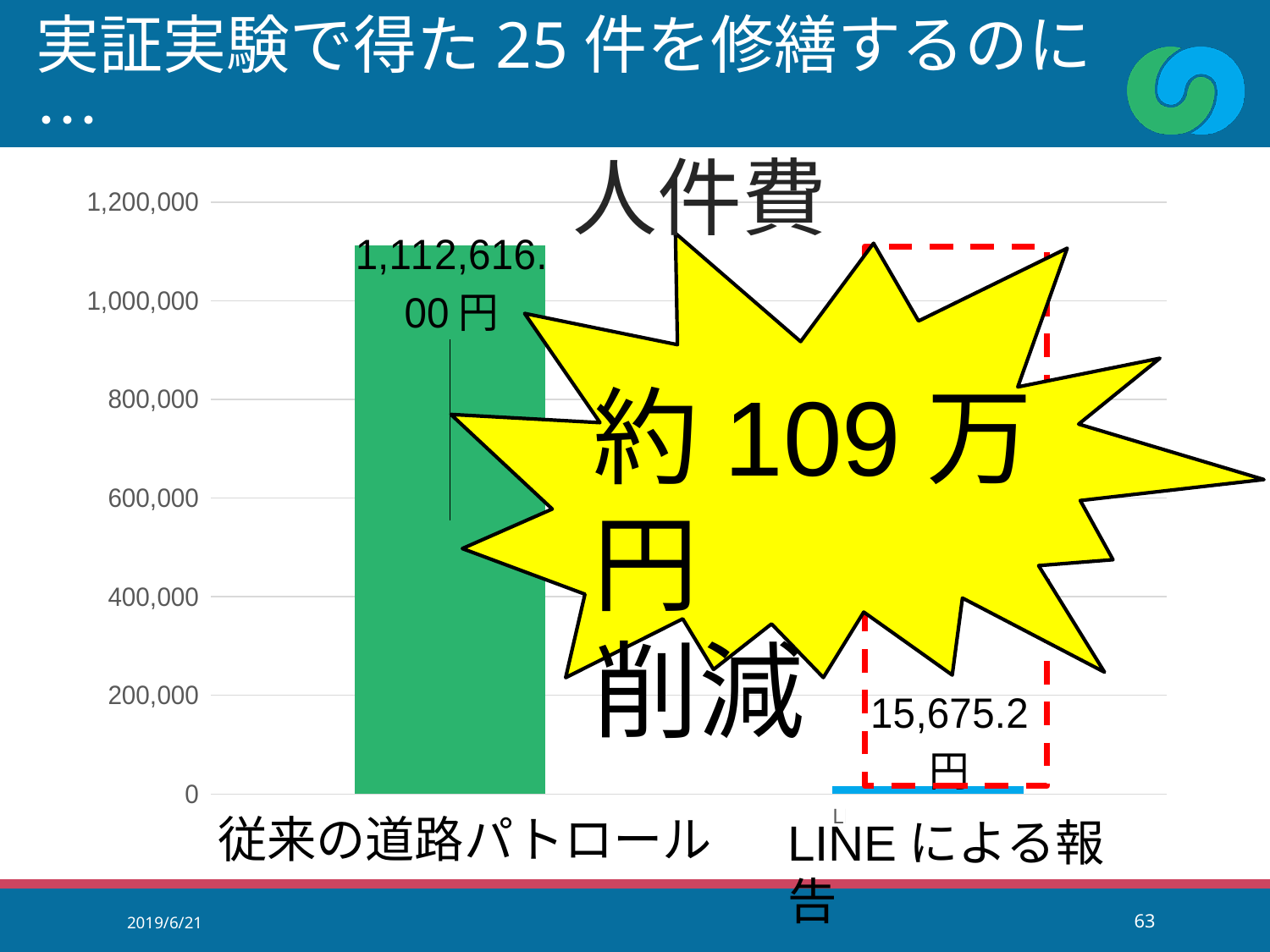
What is the difference in labor cost between 従来の道路パトロール and LINEによる報告? 1,096,940.8円 Is the labor cost for LINEによる報告 greater or less than 200,000? less What is the labor cost (人件費) for 従来の道路パトロール? 1,112,616.00円 Is the labor cost for 従来の道路パトロール greater or less than 1,000,000? greater How many categories are shown in the chart? 2 What is the highest value shown on the vertical axis? 1,200,000 Which category has the higher labor cost? 従来の道路パトロール Which category has the lower labor cost? LINEによる報告 Is the bar for LINEによる報告 larger or smaller than the bar for 従来の道路パトロール? smaller What is the labor cost (人件費) for LINEによる報告? 15,675.2円 What is the title of the chart? 人件費 What kind of chart is shown on the slide? bar chart